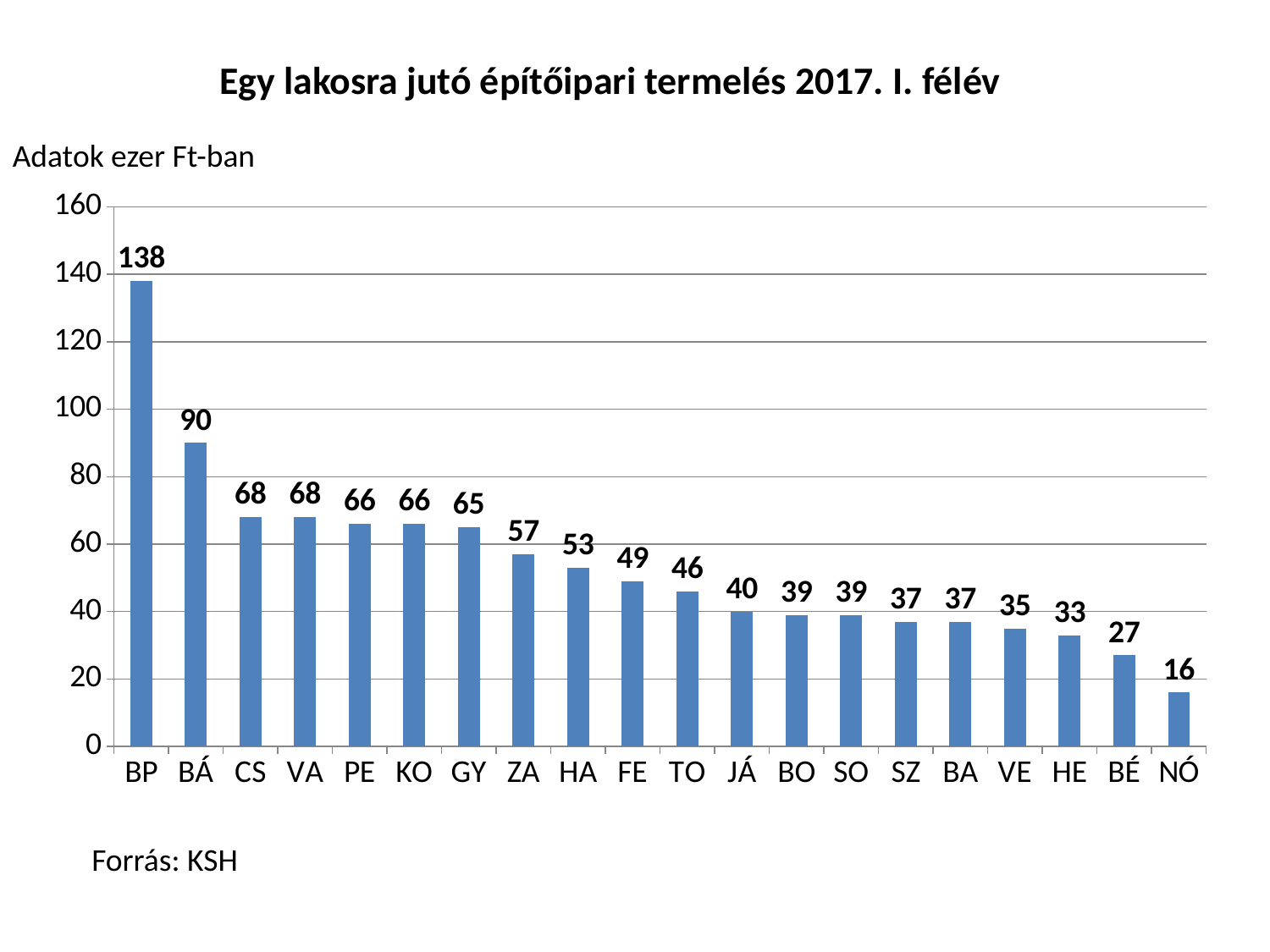
How many categories are shown on the x axis? 20 What is the value for BP? 138 Do the values rise or fall from left to right along the x axis? fall What is the value for GY? 65 Which category has the highest value? BP What kind of chart is this? bar chart What is the difference between the values for BP and BÁ? 48 What is the source cited below the chart? KSH What is the value for NÓ? 16 Which is larger, the value for ZA or the value for FE? ZA Which category has the lowest value? NÓ What is the title of the chart? Egy lakosra jutó építőipari termelés 2017. I. félév